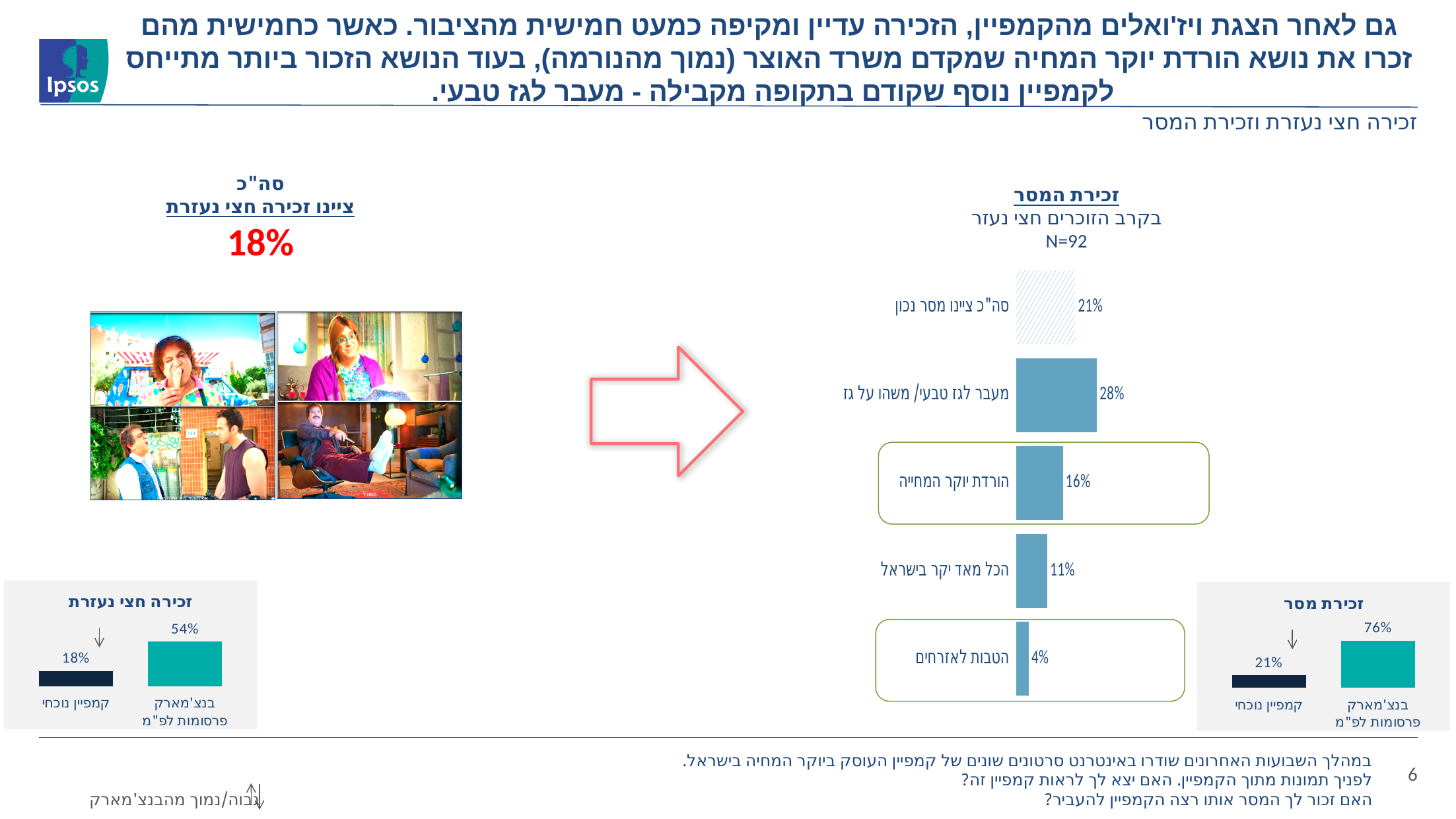
In the small chart at the bottom right titled "זכירת מסר", what is the difference between "בנצ'מארק פרסומות לפ"מ" and "קמפיין נוכחי"? 55% How many categories are shown in the main chart titled "זכירת המסר"? 5 What kind of chart is the main chart titled "זכירת המסר"? Bar chart In the main chart titled "זכירת המסר", what is the difference between "מעבר לגז טבעי/ משהו על גז" and "הורדת יוקר המחיה"? 12% What sample size (N) is shown above the main chart titled "זכירת המסר"? N=92 In the main chart titled "זכירת המסר", which is larger: "הכל מאד יקר בישראל" or "הטבות לאזרחים"? הכל מאד יקר בישראל In the main chart titled "זכירת המסר", which category has the lowest value? הטבות לאזרחים In the main chart titled "זכירת המסר", what is the value for "הורדת יוקר המחיה"? 16% In the small chart at the bottom left titled "זכירה חצי נעזרת", what is the value for "בנצ'מארק פרסומות לפ"מ"? 54% In the main chart titled "זכירת המסר", what is the value for "הטבות לאזרחים"? 4% In the main chart titled "זכירת המסר", which category has the highest value? מעבר לגז טבעי/ משהו על גז In the main chart titled "זכירת המסר", what is the value for "מעבר לגז טבעי/ משהו על גז"? 28%